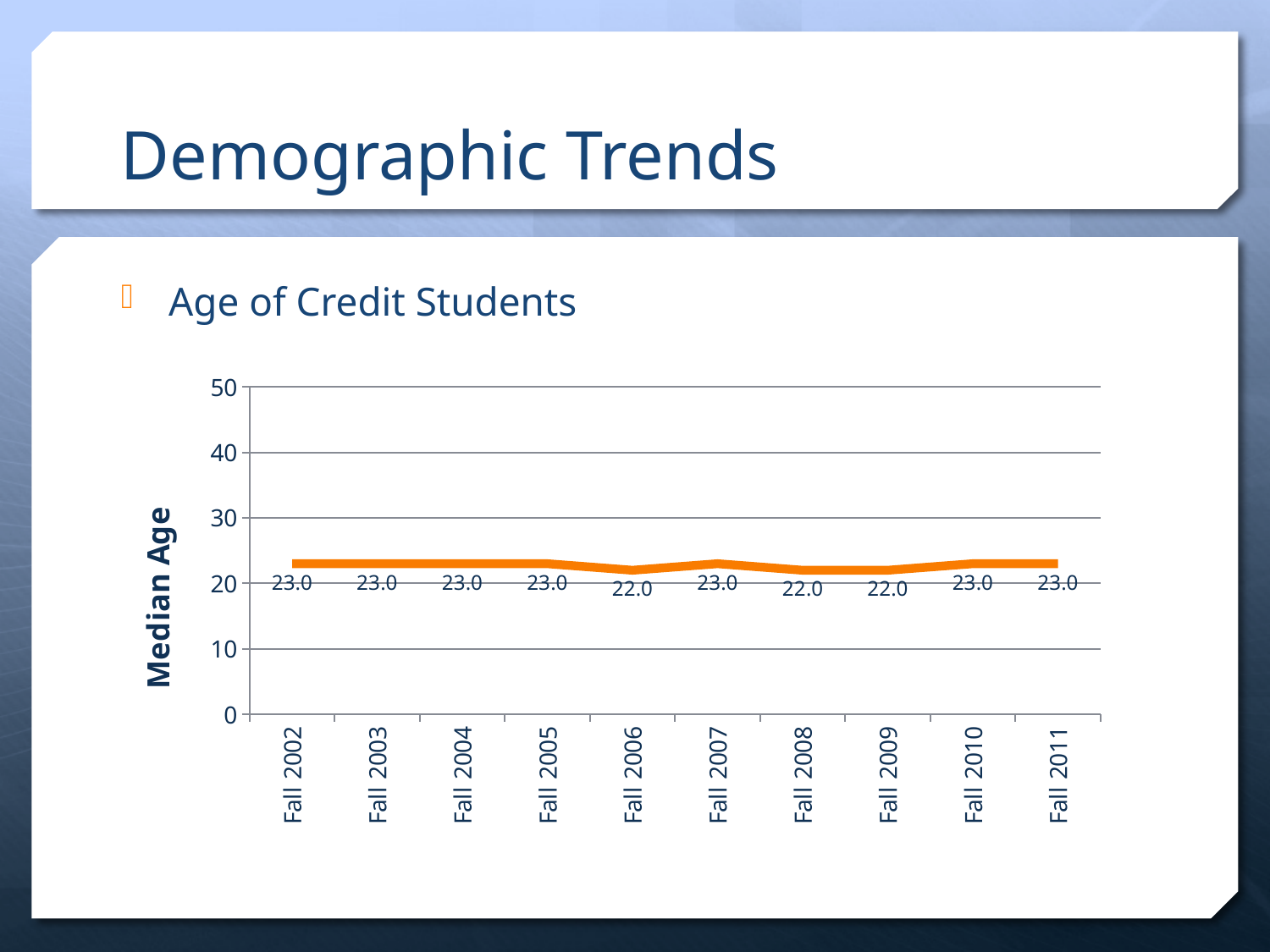
What is the highest median age value shown on the chart? 23.0 What is the label on the vertical axis of the chart? Median Age What kind of chart is shown on the slide? line chart What is the median age for Fall 2011? 23.0 What is the lowest median age value shown on the chart? 22.0 What is the difference between the median age in Fall 2007 and Fall 2008? 1.0 What is the median age for Fall 2009? 22.0 How many data points are plotted on the chart? 10 What is the median age for Fall 2002? 23.0 Which is larger, the median age in Fall 2005 or Fall 2006? Fall 2005 What is the median age for Fall 2006? 22.0 Is the median age for Fall 2010 greater or less than 30? less